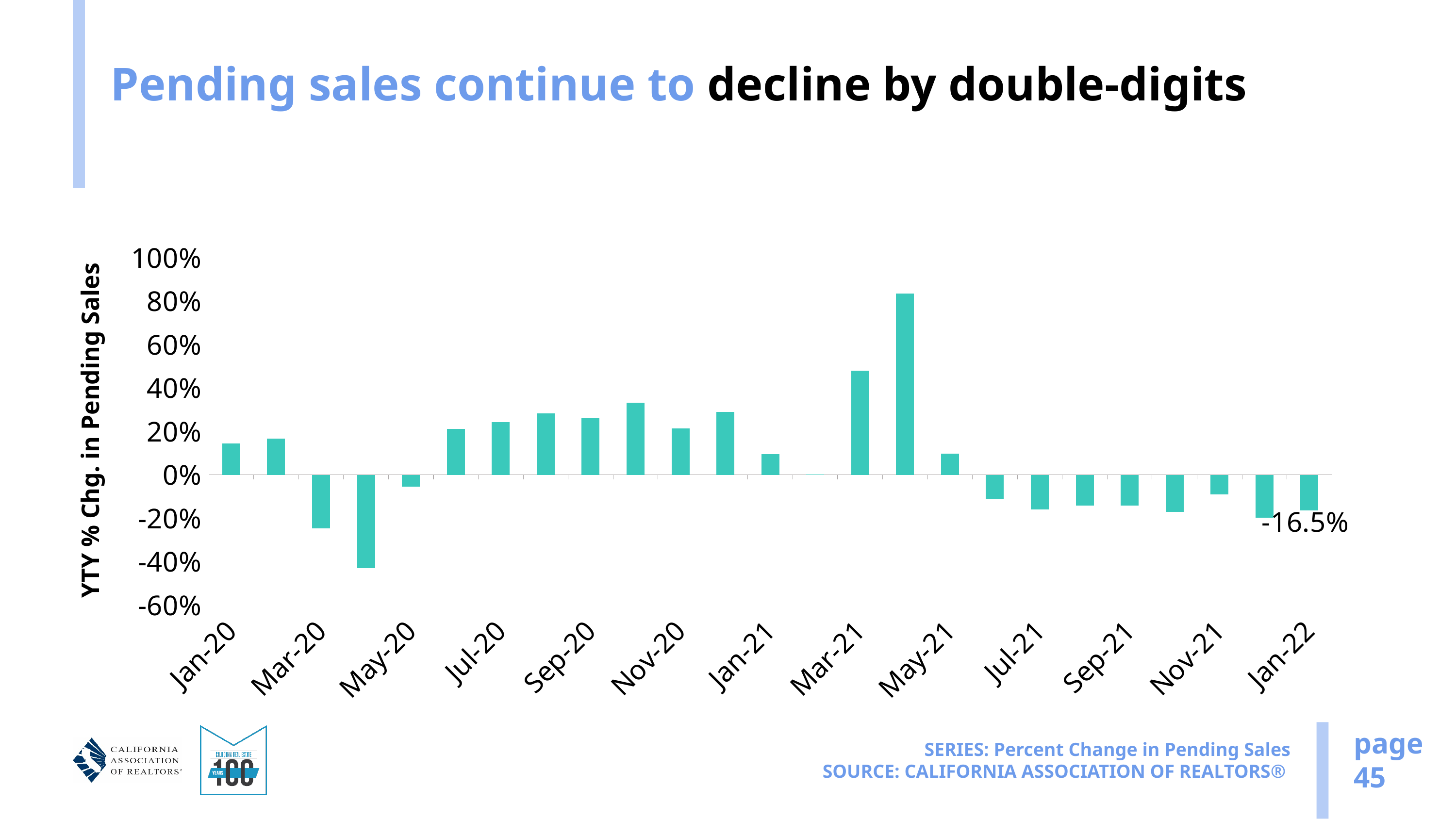
Which is larger, the value for Jan-20 or the value for Mar-20? Jan-20 Is the value for Jan-21 greater or less than 20%? less Is the value for Mar-20 greater or less than -20%? less How many bars are plotted in the chart? 25 Is the value for Sep-20 greater or less than 20%? greater Which is larger, the value for Mar-21 or the value for Jan-21? Mar-21 From May-20 to Jul-20, do the values rise or fall? rise What kind of chart is shown on the slide? bar chart What is the title of the vertical axis? YTY % Chg. in Pending Sales What is the value for Jan-22? -16.5%